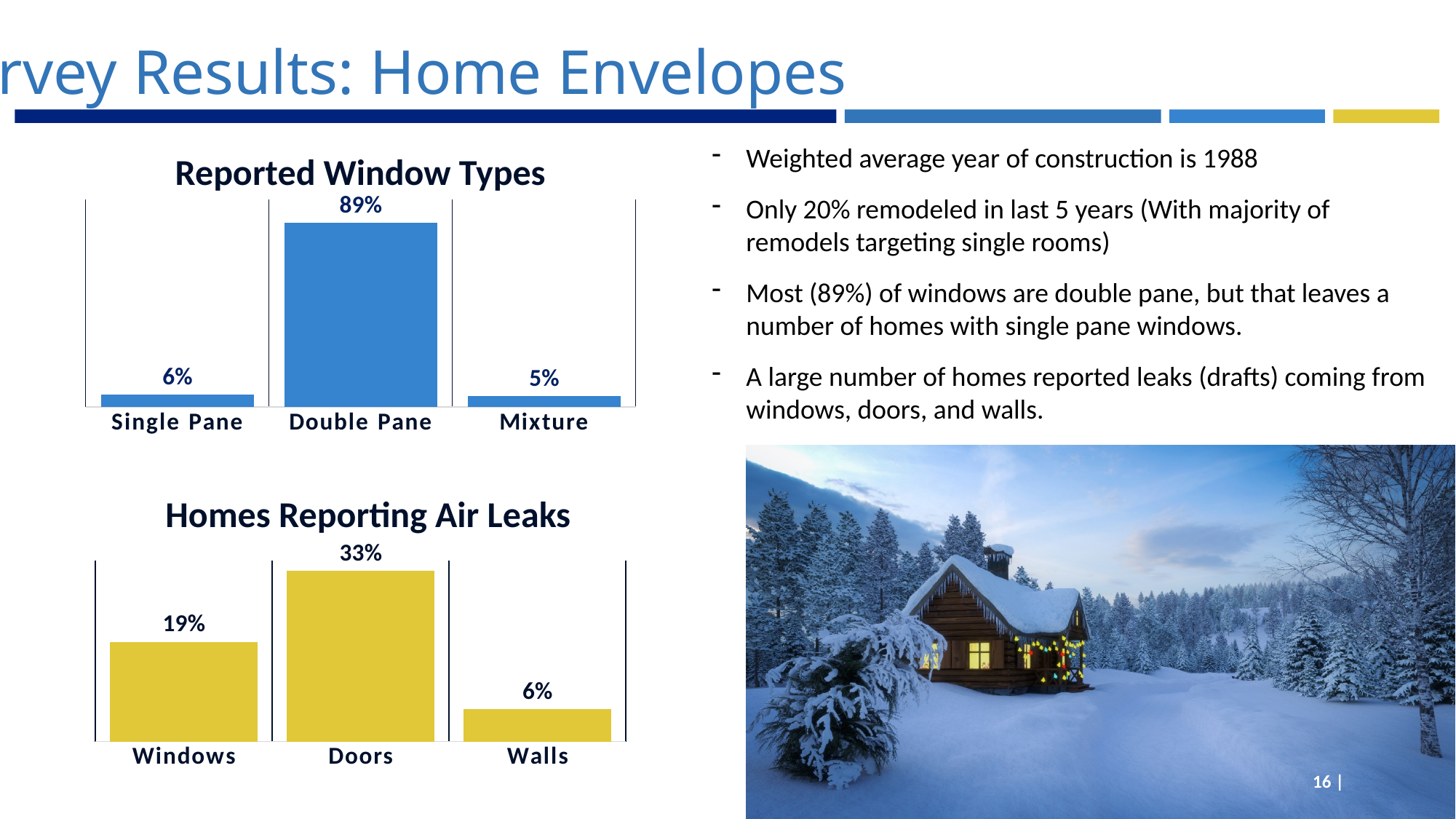
In the 'Reported Window Types' chart, how many window types are shown? 3 In the 'Reported Window Types' chart, what is the difference between Double Pane and Single Pane? 83% In the 'Reported Window Types' chart, which window type has the lowest value? Mixture What kind of chart is the 'Homes Reporting Air Leaks' chart? Bar chart In the 'Homes Reporting Air Leaks' chart, which category has the highest value? Doors In the 'Homes Reporting Air Leaks' chart, what is the value for Walls? 6% In the 'Homes Reporting Air Leaks' chart, what is the value for Doors? 33% In the 'Homes Reporting Air Leaks' chart, which is larger, Windows or Walls? Windows In the 'Reported Window Types' chart, what is the value for Single Pane? 6% What colour are the bars in the 'Homes Reporting Air Leaks' chart? Yellow In the 'Homes Reporting Air Leaks' chart, what is the difference between Doors and Windows? 14% In the 'Reported Window Types' chart, what is the value for Double Pane? 89%